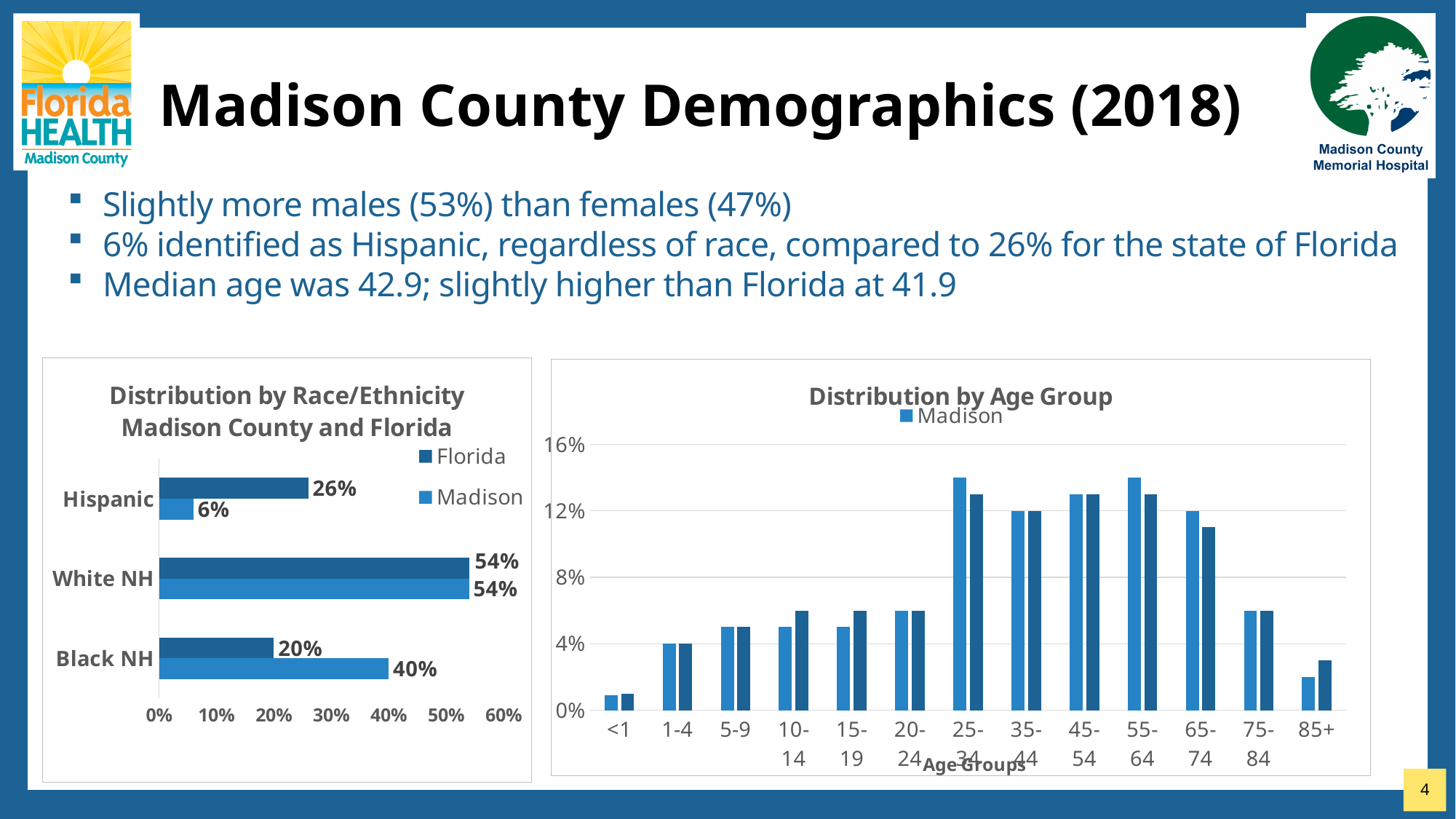
In the Distribution by Race/Ethnicity chart, what is the Madison value for Black NH? 40% In the Distribution by Race/Ethnicity chart, what is the Madison value for White NH? 54% What is the x-axis title of the Distribution by Age Group chart? Age Groups In the Distribution by Race/Ethnicity chart, which is larger for Hispanic: the Florida value or the Madison value? Florida What kind of chart is the Distribution by Age Group chart? Bar chart In the Distribution by Age Group chart, is the Madison value for 85+ greater or less than 4%? less In the Distribution by Race/Ethnicity chart, what is the Florida value for Hispanic? 26% How many series does the legend of the Distribution by Race/Ethnicity chart list? 2 How many age groups are shown on the x axis of the Distribution by Age Group chart? 13 In the Distribution by Race/Ethnicity chart, what is the difference between the Madison and Florida values for Black NH? 20% In the Distribution by Age Group chart, is the Madison value for 25-34 greater or less than 12%? greater In the Distribution by Race/Ethnicity chart, which category has the lowest Madison value? Hispanic